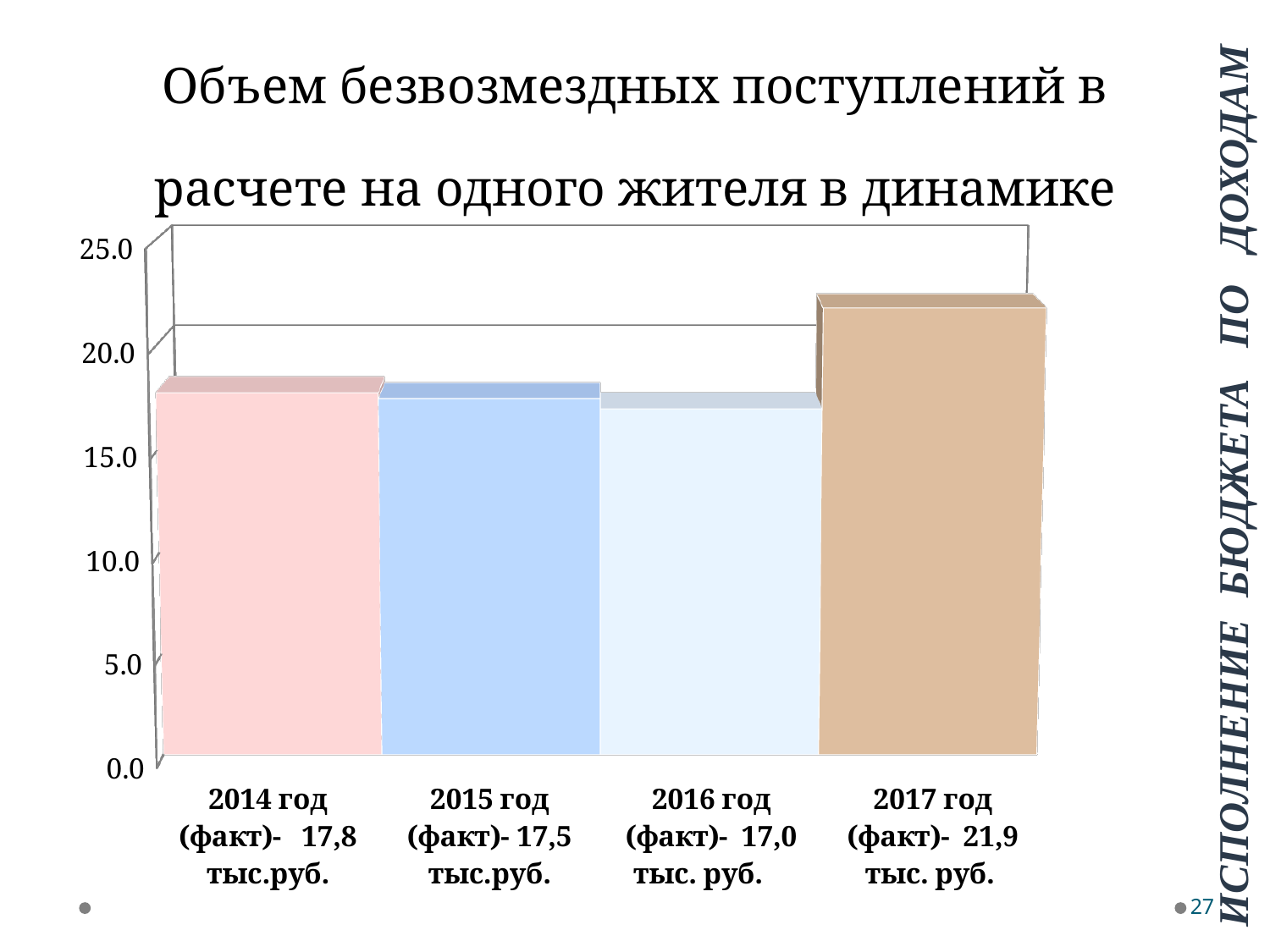
What is the difference between the 2017 and 2016 values? 4,9 тыс. руб. What is the difference between the 2014 and 2015 values? 0,3 тыс. руб. What is the value for 2014 год (факт)? 17,8 тыс.руб. Which is larger, the value for 2014 or the value for 2015? 2014 What kind of chart is shown on the slide? bar chart How many years are shown on the chart? 4 What is the value for 2016 год (факт)? 17,0 тыс. руб. What is the title of the chart? Объем безвозмездных поступлений в расчете на одного жителя в динамике Which year has the lowest value? 2016 год Which year has the highest value? 2017 год Is the value for 2017 greater or less than 20.0? greater What is the value for 2017 год (факт)? 21,9 тыс. руб.